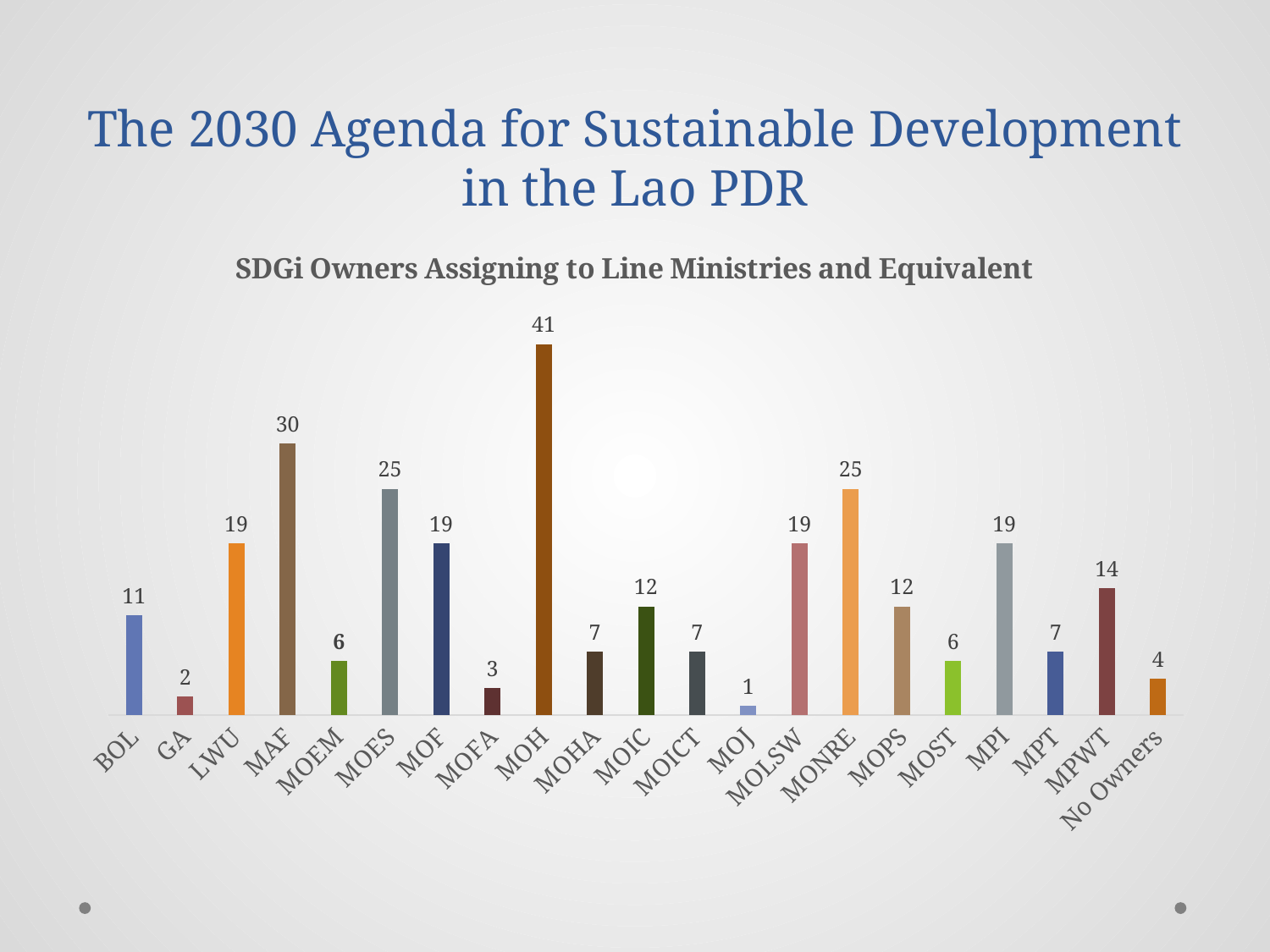
What is the difference between the values for MONRE and MOPS? 13 What is the title of the chart? SDGi Owners Assigning to Line Ministries and Equivalent Which category has the lowest value? MOJ What is the value for MAF? 30 What is the value for MOH in the chart? 41 What is the value for No Owners? 4 Which category has the highest value? MOH What kind of chart is shown on the slide? Bar chart How many categories are shown on the x axis? 21 Which is larger, the value for MOES or the value for LWU? MOES What is the difference between the values for MOH and MAF? 11 What is the value for MPWT? 14